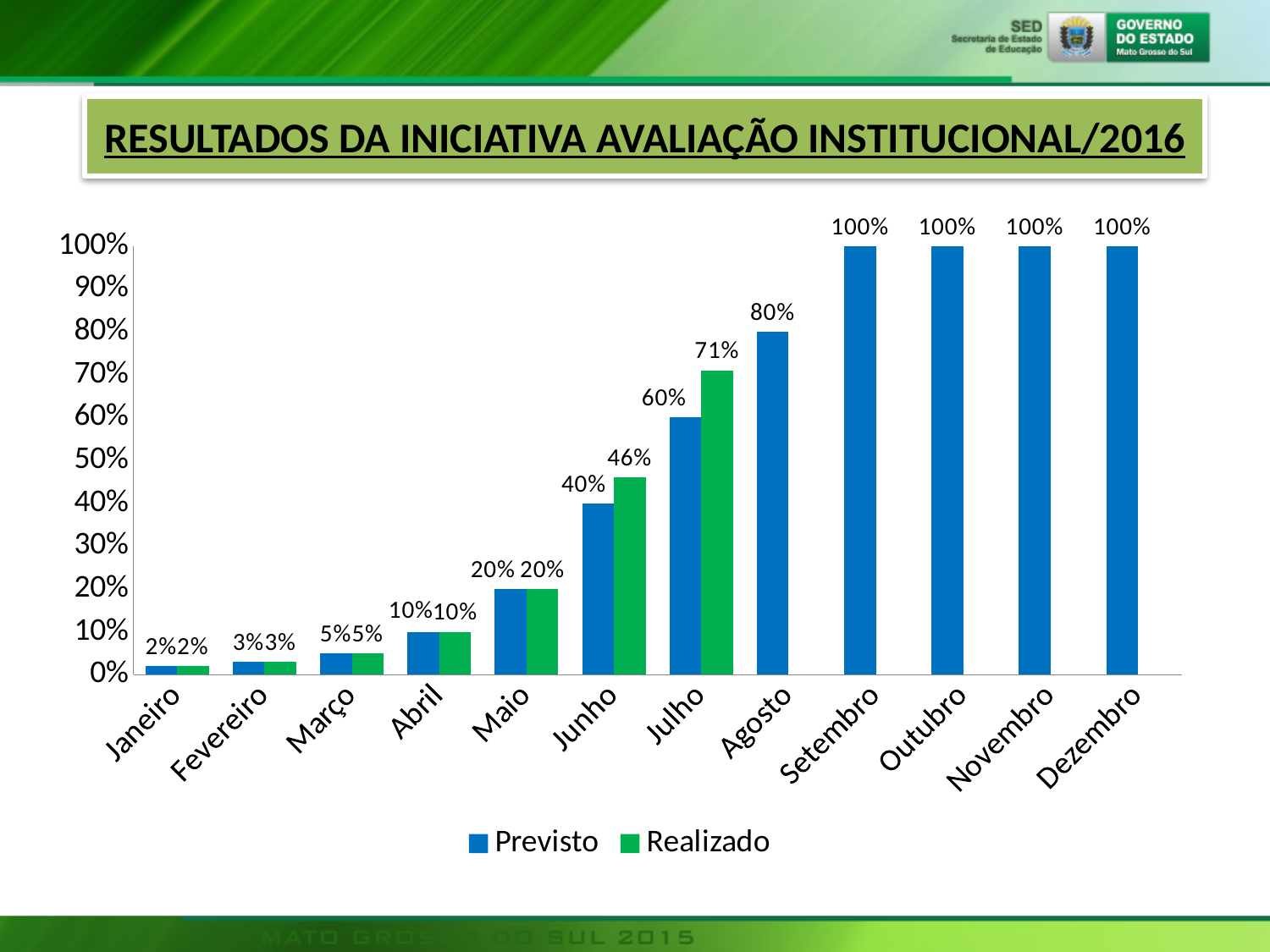
Do the Previsto values rise or fall from Janeiro to Setembro? Rise What is the Previsto value for Julho? 60% What is the difference between the Realizado and Previsto values for Julho? 11% Which is larger for Junho, the Previsto value or the Realizado value? Realizado What is the Realizado value for Junho? 46% Which month has the lowest Previsto value? Janeiro How many months are shown on the x axis? 12 What is the Realizado value for Julho? 71% What kind of chart is shown on the slide? Bar chart How many series does the legend list? 2 What is the Previsto value for Agosto? 80% What is the difference between the Realizado and Previsto values for Junho? 6%